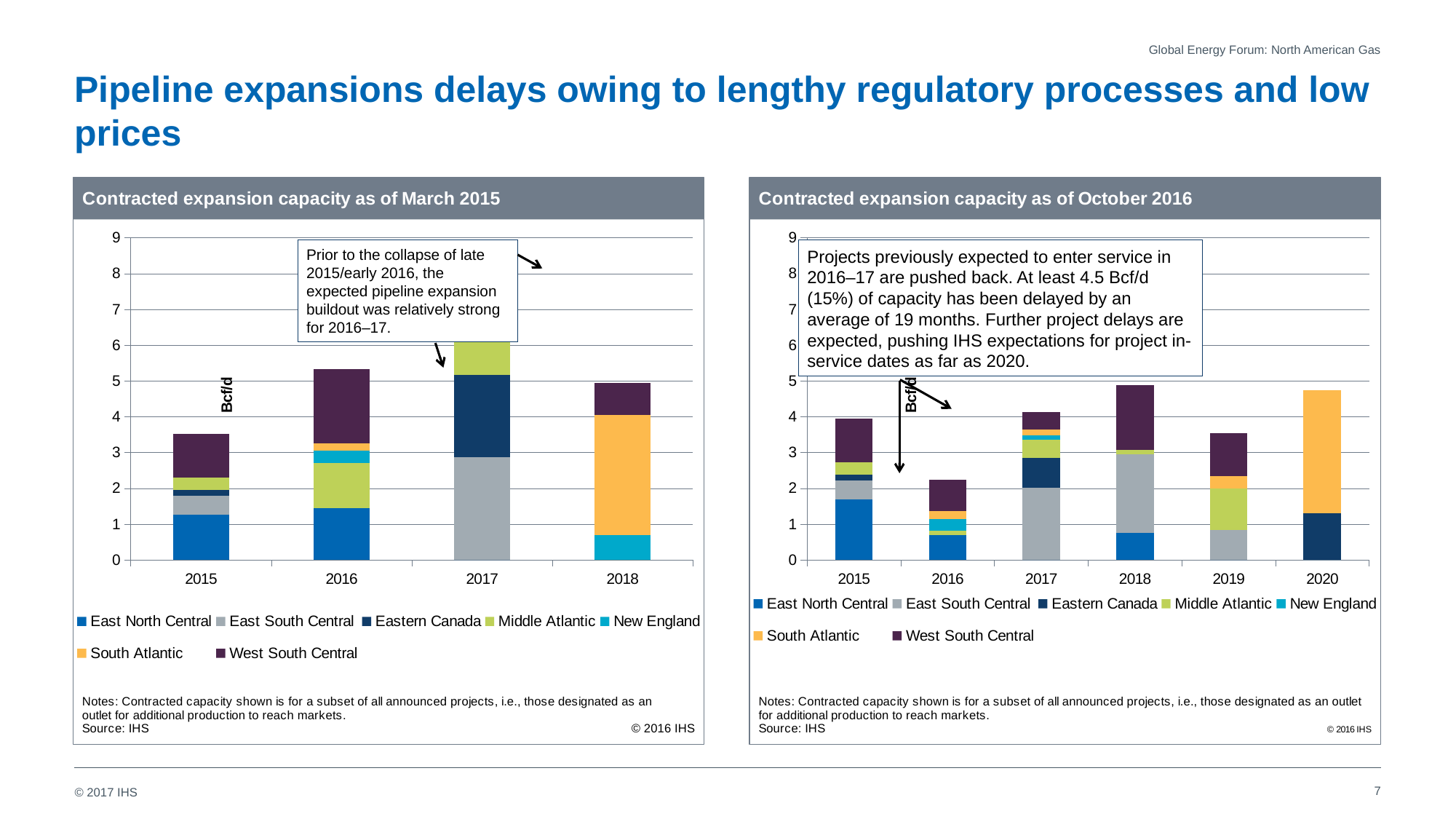
In the 'Contracted expansion capacity as of March 2015' chart, is the total for 2016 greater or less than 5? greater What kind of chart is the 'Contracted expansion capacity as of March 2015' chart? Stacked bar chart In the 'Contracted expansion capacity as of October 2016' chart, which year has the lowest total contracted capacity? 2016 In the 'Contracted expansion capacity as of March 2015' chart, which year has the lowest total contracted capacity? 2015 In the 'Contracted expansion capacity as of October 2016' chart, is the total for 2016 greater or less than 3? less In the 'Contracted expansion capacity as of March 2015' chart, which year has the highest total contracted capacity? 2017 How many years are shown on the x axis of the 'Contracted expansion capacity as of March 2015' chart? 4 In the 'Contracted expansion capacity as of October 2016' chart, is the total for 2020 greater or less than 4? greater What unit is shown on the y axis of the 'Contracted expansion capacity as of March 2015' chart? Bcf/d How many series does the legend of the 'Contracted expansion capacity as of October 2016' chart list? 7 In the 'Contracted expansion capacity as of October 2016' chart, which year has the larger total, 2016 or 2017? 2017 How many years are shown on the x axis of the 'Contracted expansion capacity as of October 2016' chart? 6